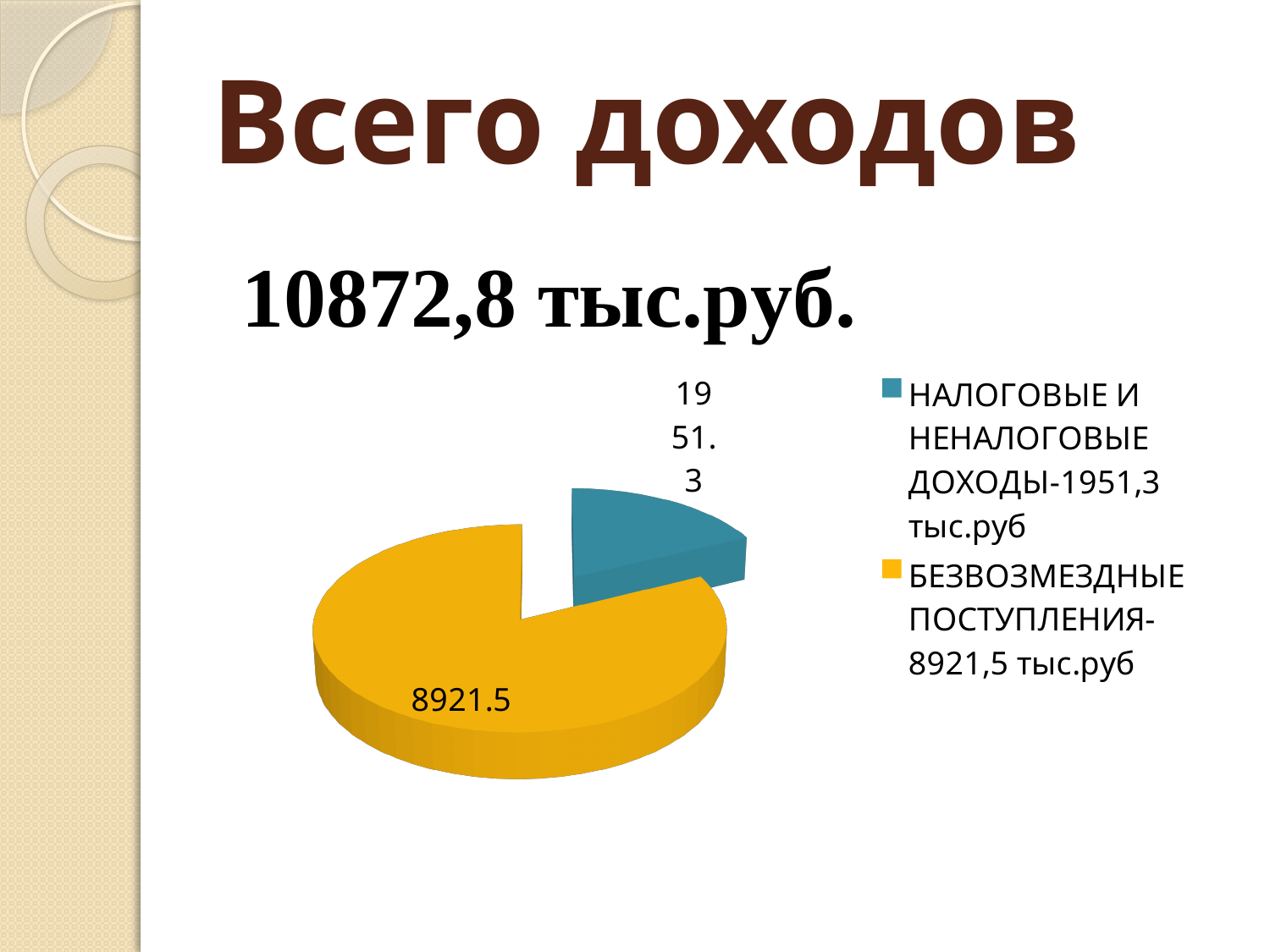
What colour is the slice for НАЛОГОВЫЕ И НЕНАЛОГОВЫЕ ДОХОДЫ? blue Which category has the largest slice of the pie? БЕЗВОЗМЕЗДНЫЕ ПОСТУПЛЕНИЯ What total income figure is stated in the slide heading? 10872,8 тыс.руб. How many entries does the legend of the pie chart list? 2 What is the difference between the values of the two slices (8921.5 and 1951.3)? 6970.2 Which is larger: БЕЗВОЗМЕЗДНЫЕ ПОСТУПЛЕНИЯ or НАЛОГОВЫЕ И НЕНАЛОГОВЫЕ ДОХОДЫ? БЕЗВОЗМЕЗДНЫЕ ПОСТУПЛЕНИЯ What is the total of the two slice values shown on the pie chart? 10872.8 What kind of chart is shown on the slide? pie chart What value is labelled on the blue slice (НАЛОГОВЫЕ И НЕНАЛОГОВЫЕ ДОХОДЫ)? 1951.3 How many slices does the pie chart have? 2 Which category has the smallest slice of the pie? НАЛОГОВЫЕ И НЕНАЛОГОВЫЕ ДОХОДЫ What value is labelled on the yellow slice (БЕЗВОЗМЕЗДНЫЕ ПОСТУПЛЕНИЯ)? 8921.5